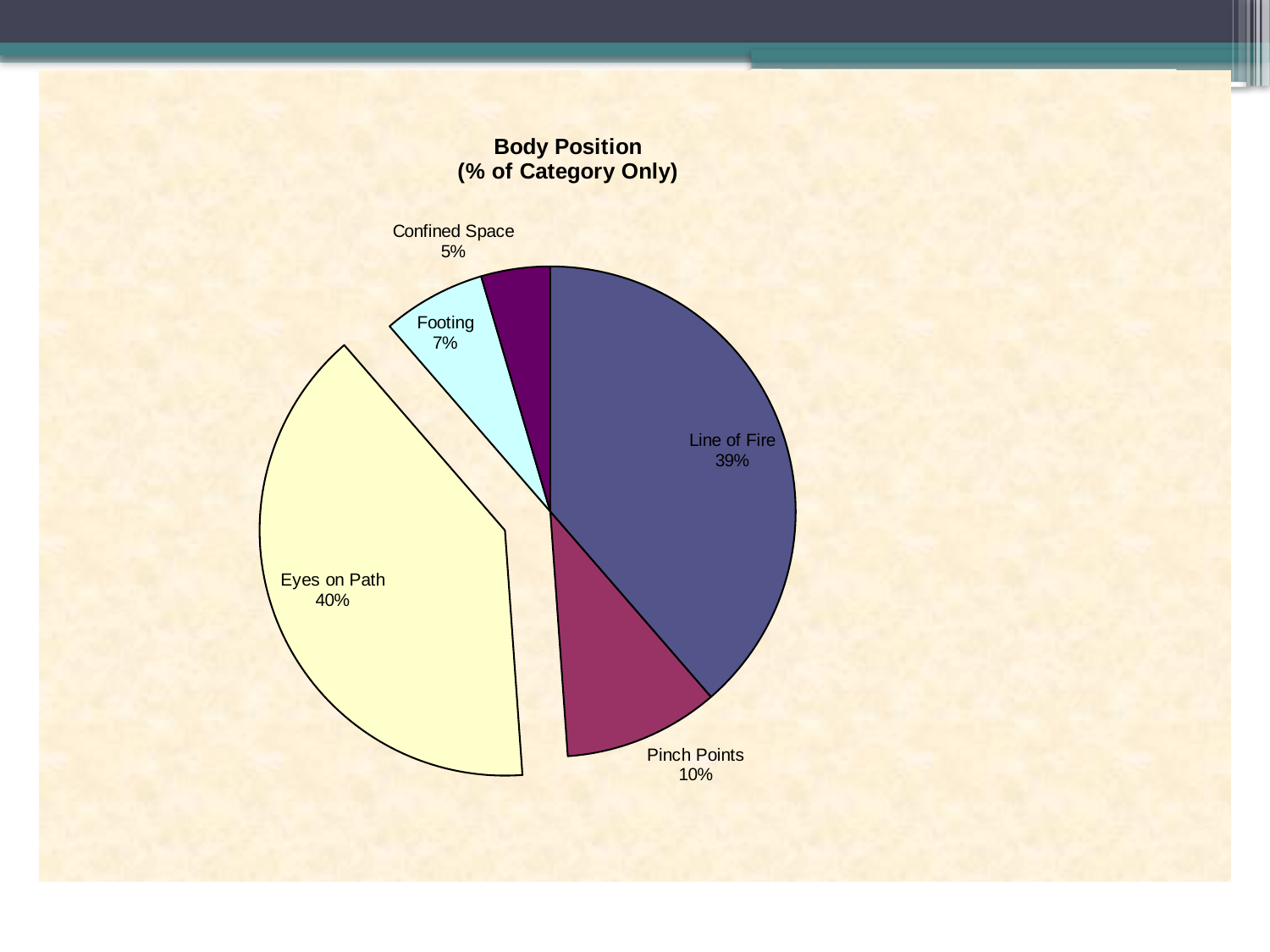
What is the title of the chart? Body Position (% of Category Only) What percentage does the Pinch Points slice represent? 10% What kind of chart is shown on the slide? pie chart What is the combined share of Footing and Confined Space? 12% What percentage does the Confined Space slice represent? 5% Which category has the smallest share of the pie? Confined Space What percentage does the Line of Fire slice represent? 39% What percentage does the Eyes on Path slice represent? 40% How many slices does the pie chart have? 5 What is the difference in percentage points between Pinch Points and Footing? 3 Which is larger, the Pinch Points slice or the Confined Space slice? Pinch Points What percentage does the Footing slice represent? 7%